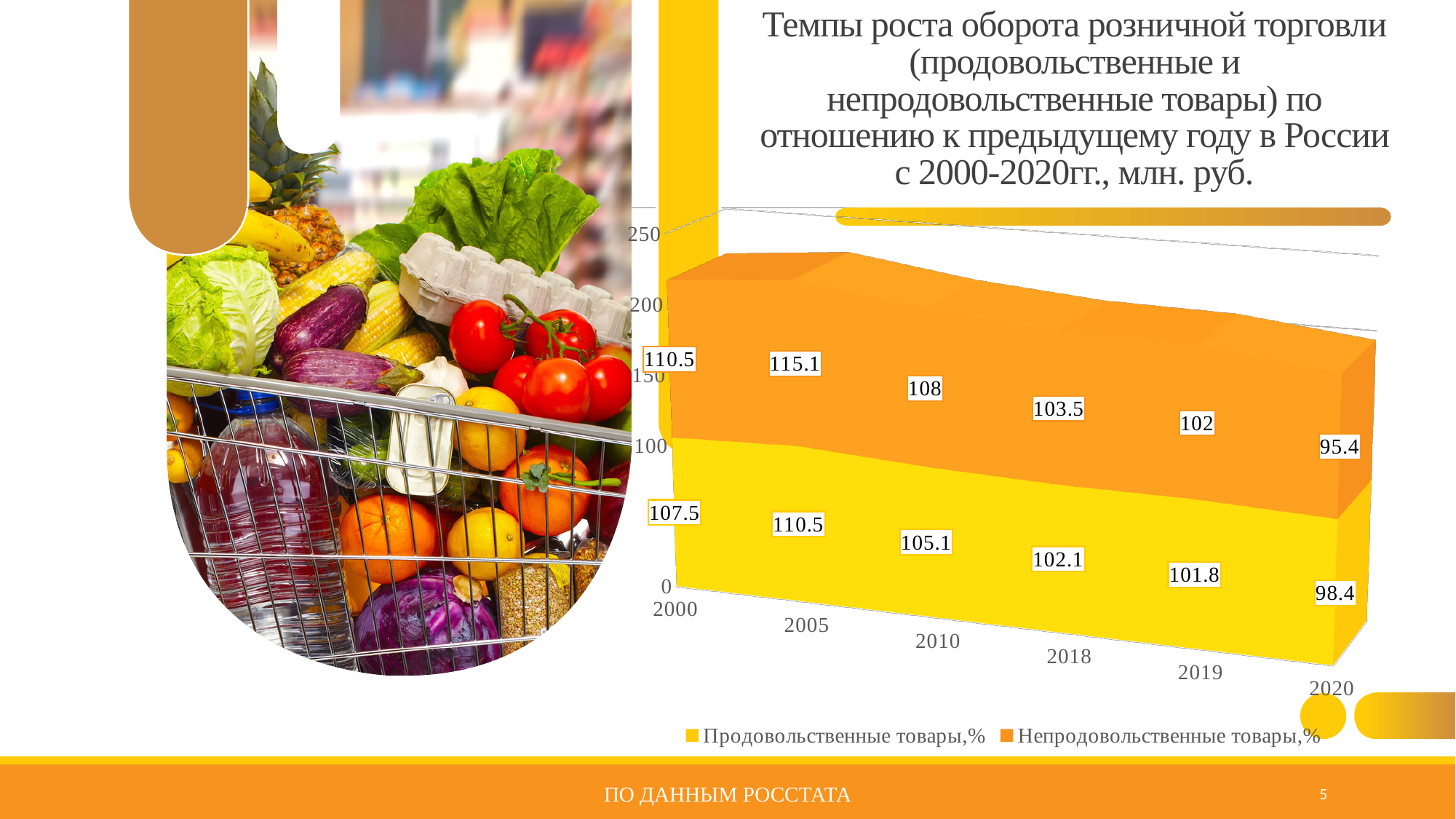
In which year is the value for Непродовольственные товары,% highest? 2005 What kind of chart is shown on the slide? Area chart What is the difference between the Непродовольственные товары,% values in 2005 and 2018? 11.6 What is the value for Продовольственные товары,% in 2005? 110.5 How many years are shown on the x axis? 6 What is the value for Продовольственные товары,% in 2019? 101.8 What is the value for Непродовольственные товары,% in 2020? 95.4 What is the value for Непродовольственные товары,% in 2010? 108 Which is larger in 2000: Продовольственные товары,% or Непродовольственные товары,%? Непродовольственные товары,% How many series does the legend list? 2 In which year is the value for Продовольственные товары,% lowest? 2020 What is the combined total of the two series in 2018? 205.6